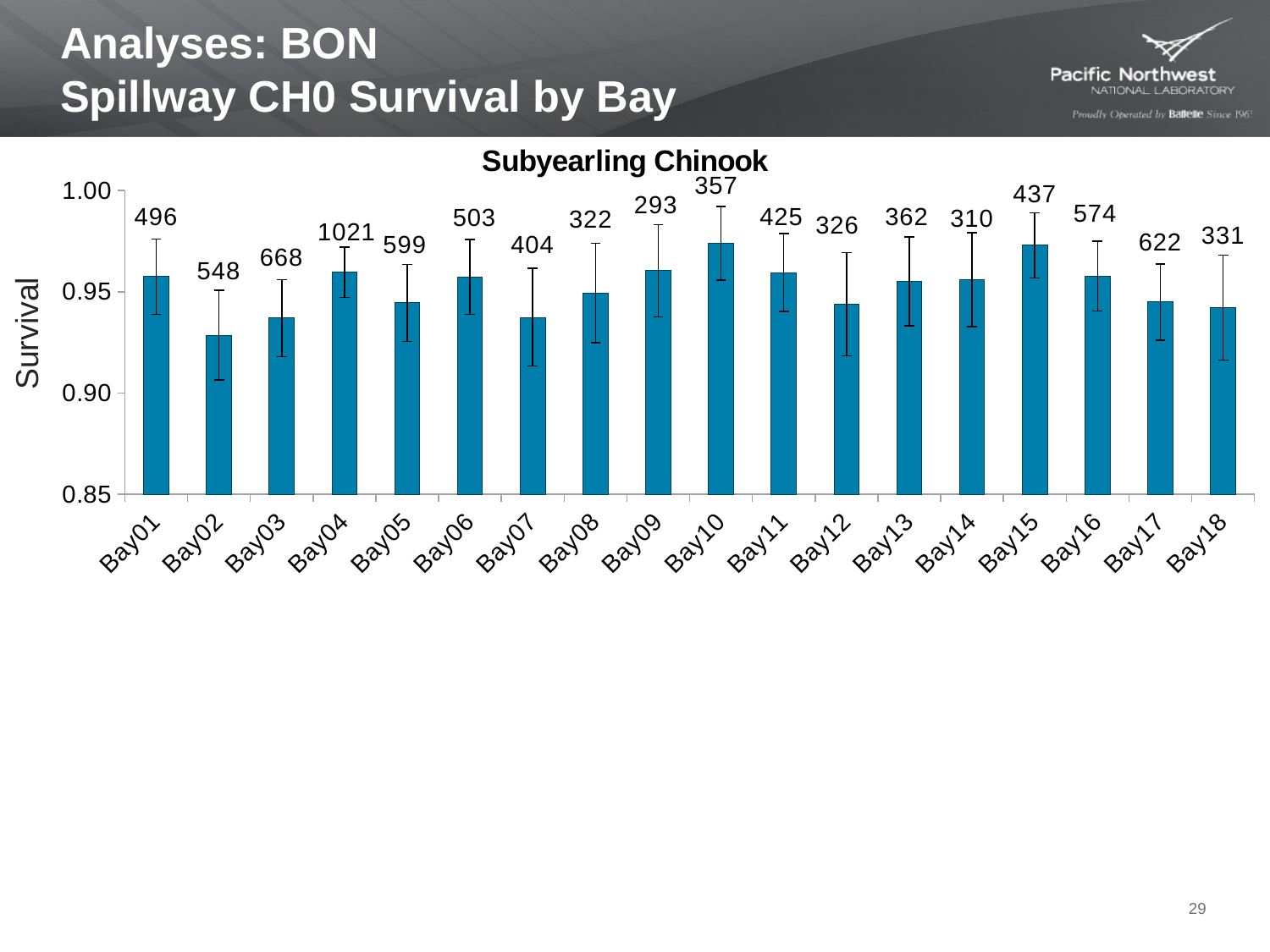
Is the survival value for Bay07 greater or less than 0.95? less What is the label of the y axis? Survival Which has the higher survival value, Bay04 or Bay07? Bay04 What number is printed above the bar for Bay04? 1021 Is the survival value for Bay02 greater or less than 0.95? less Which bay has the lowest survival value? Bay02 How many bays are shown on the x axis of the chart? 18 Which has the higher survival value, Bay02 or Bay10? Bay10 What is the title of the chart? Subyearling Chinook Is the survival value for Bay15 greater or less than 0.95? greater What kind of chart is shown on the slide? bar chart